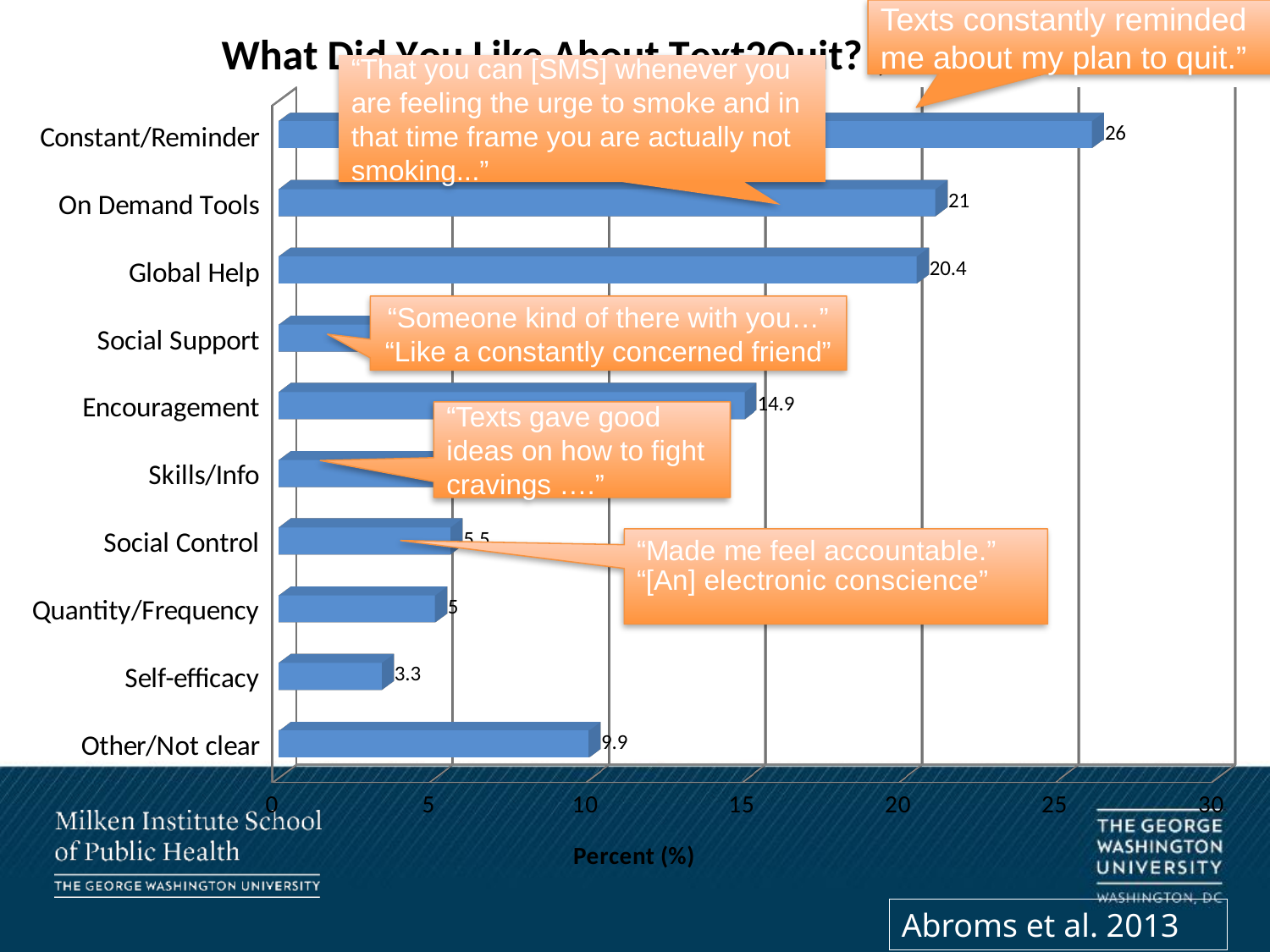
What is the value for Constant/Reminder? 26 Which category has the highest value? Constant/Reminder What is the value for Global Help? 20.4 What is the value for Other/Not clear? 9.9 What is the value for Encouragement? 14.9 What is the value for On Demand Tools? 21 How many categories are shown on the chart? 10 What kind of chart is shown on the slide? Bar chart What is the difference between the values for Constant/Reminder and On Demand Tools? 5 What is the value for Quantity/Frequency? 5 What is the value for Self-efficacy? 3.3 Which is larger, the value for Global Help or the value for Encouragement? Global Help